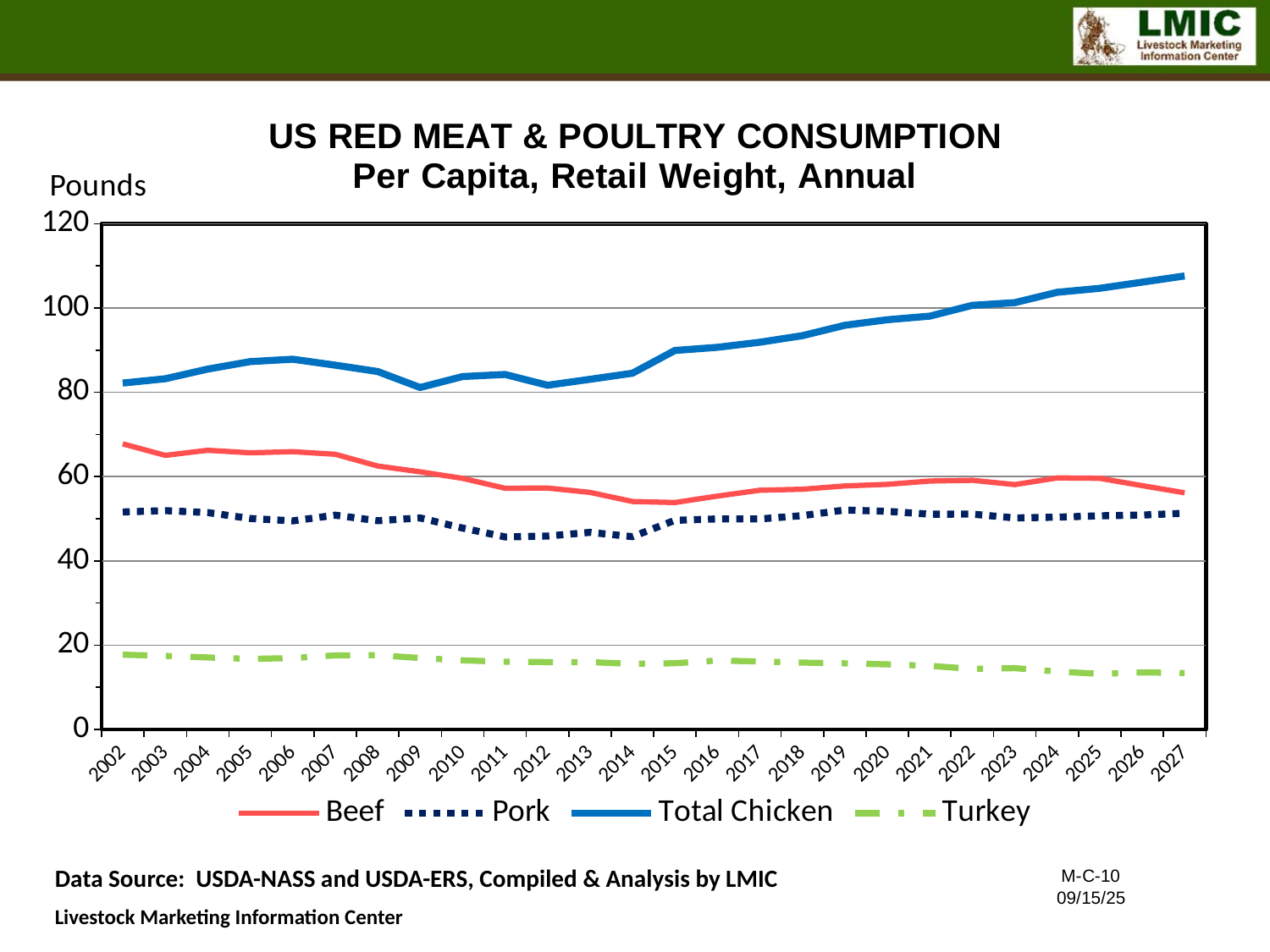
Is the value for Turkey in 2027 greater or less than 20? less Which series has the lowest value in 2002? Turkey Is the value for Beef in 2002 greater or less than 60? greater Does the Total Chicken series generally rise or fall from 2002 to 2027? rise What kind of chart is shown on the slide? line chart How many series does the legend list? 4 Which is larger in 2002, Beef or Pork? Beef Is the value for Total Chicken in 2027 greater or less than 100? greater What unit is shown on the y axis label? Pounds How many years are shown along the x axis? 26 Which series has the highest value in 2027? Total Chicken